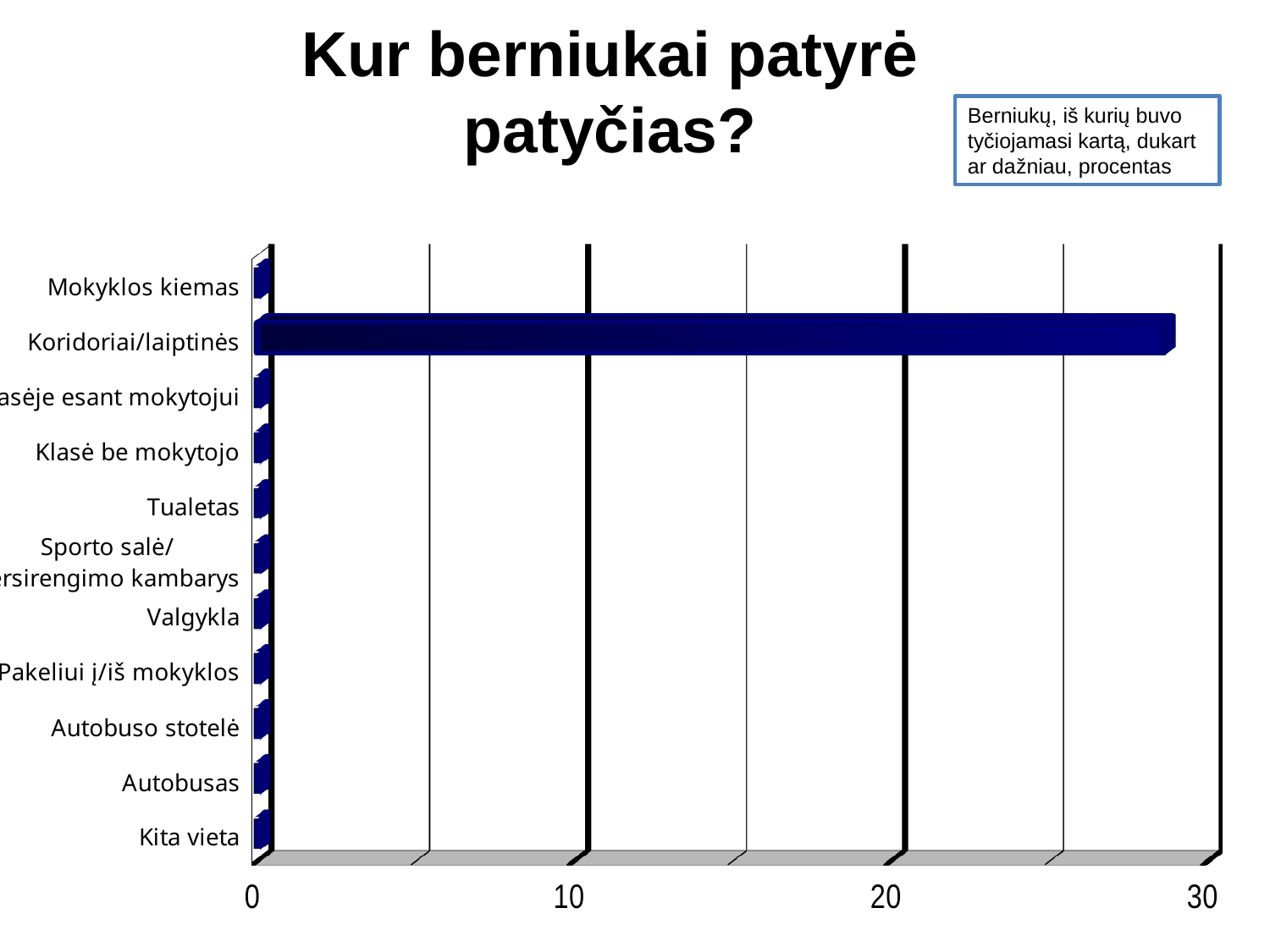
What is the highest value shown on the horizontal axis? 30 Is the value for Autobusas greater or less than 10? less Which is larger, the value for Koridoriai/laiptinės or the value for Valgykla? Koridoriai/laiptinės Which category has the highest value? Koridoriai/laiptinės Is the value for Koridoriai/laiptinės greater or less than 30? less Is the value for Koridoriai/laiptinės greater or less than 20? greater How many categories are plotted on the chart? 11 What is the title of the chart? Kur berniukai patyrė patyčias? Which is larger, the value for Mokyklos kiemas or the value for Koridoriai/laiptinės? Koridoriai/laiptinės What kind of chart is shown on the slide? Bar chart